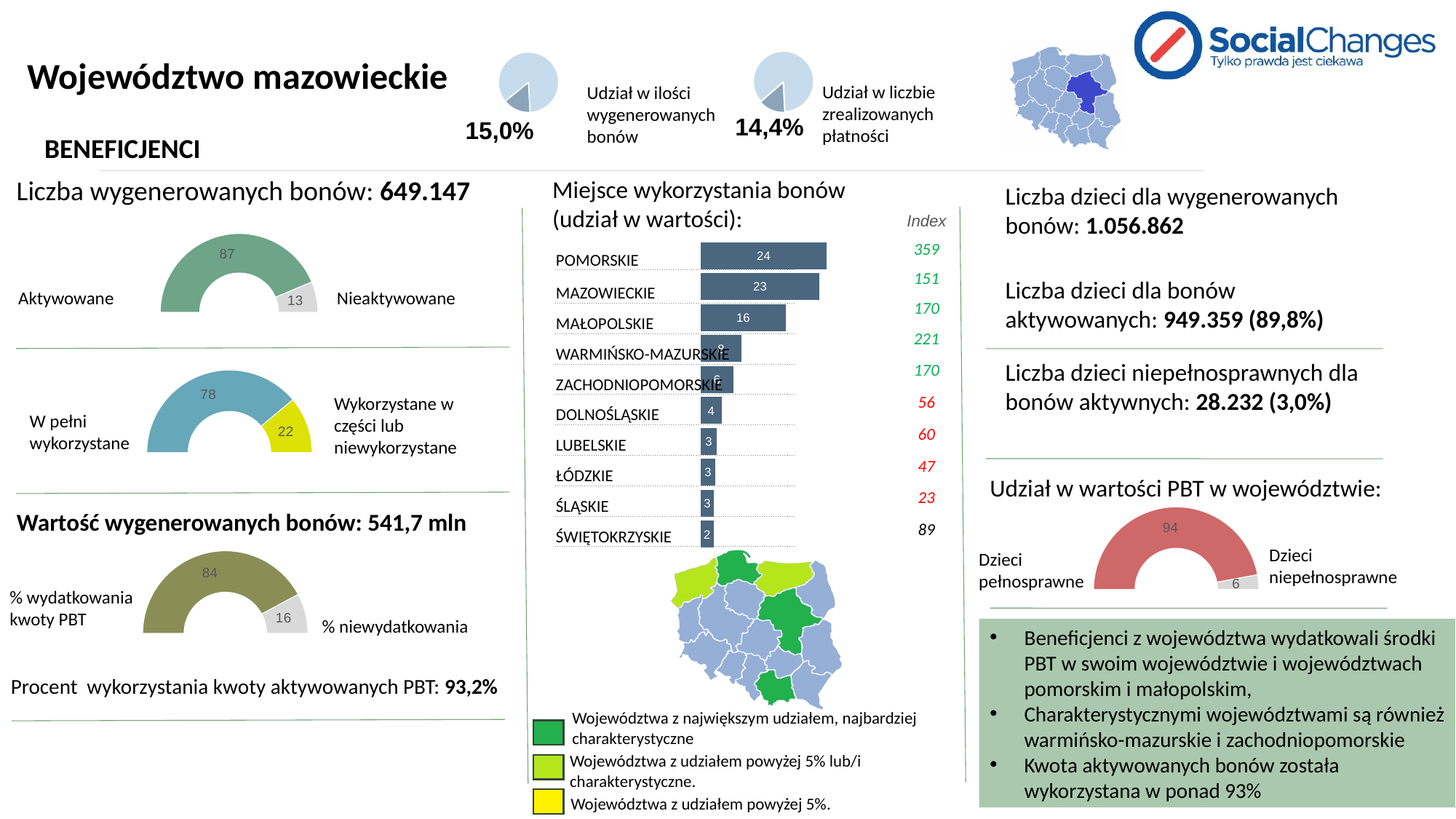
In the bar chart 'Miejsce wykorzystania bonów (udział w wartości)', what is the difference between the values for POMORSKIE and MAZOWIECKIE? 1 In the half-donut chart under 'Liczba wygenerowanych bonów', which is larger, Aktywowane or Nieaktywowane? Aktywowane What kind of chart is 'Miejsce wykorzystania bonów (udział w wartości)'? Bar chart How many voivodeships are listed in the bar chart 'Miejsce wykorzystania bonów (udział w wartości)'? 10 In the bar chart 'Miejsce wykorzystania bonów (udział w wartości)', which voivodeship has the highest value? POMORSKIE In the half-donut chart with 'W pełni wykorzystane', what is the value for 'Wykorzystane w części lub niewykorzystane'? 22 In the half-donut chart under 'Liczba wygenerowanych bonów', what is the value for Aktywowane? 87 In the bar chart 'Miejsce wykorzystania bonów (udział w wartości)', what is the value for MAŁOPOLSKIE? 16 In the half-donut chart under 'Udział w wartości PBT w województwie', what is the value for Dzieci niepełnosprawne? 6 In the bar chart 'Miejsce wykorzystania bonów (udział w wartości)', what is the value for POMORSKIE? 24 In the bar chart 'Miejsce wykorzystania bonów (udział w wartości)', what is the Index value shown for POMORSKIE? 359 In the bar chart 'Miejsce wykorzystania bonów (udział w wartości)', which voivodeship has the lowest value? ŚWIĘTOKRZYSKIE